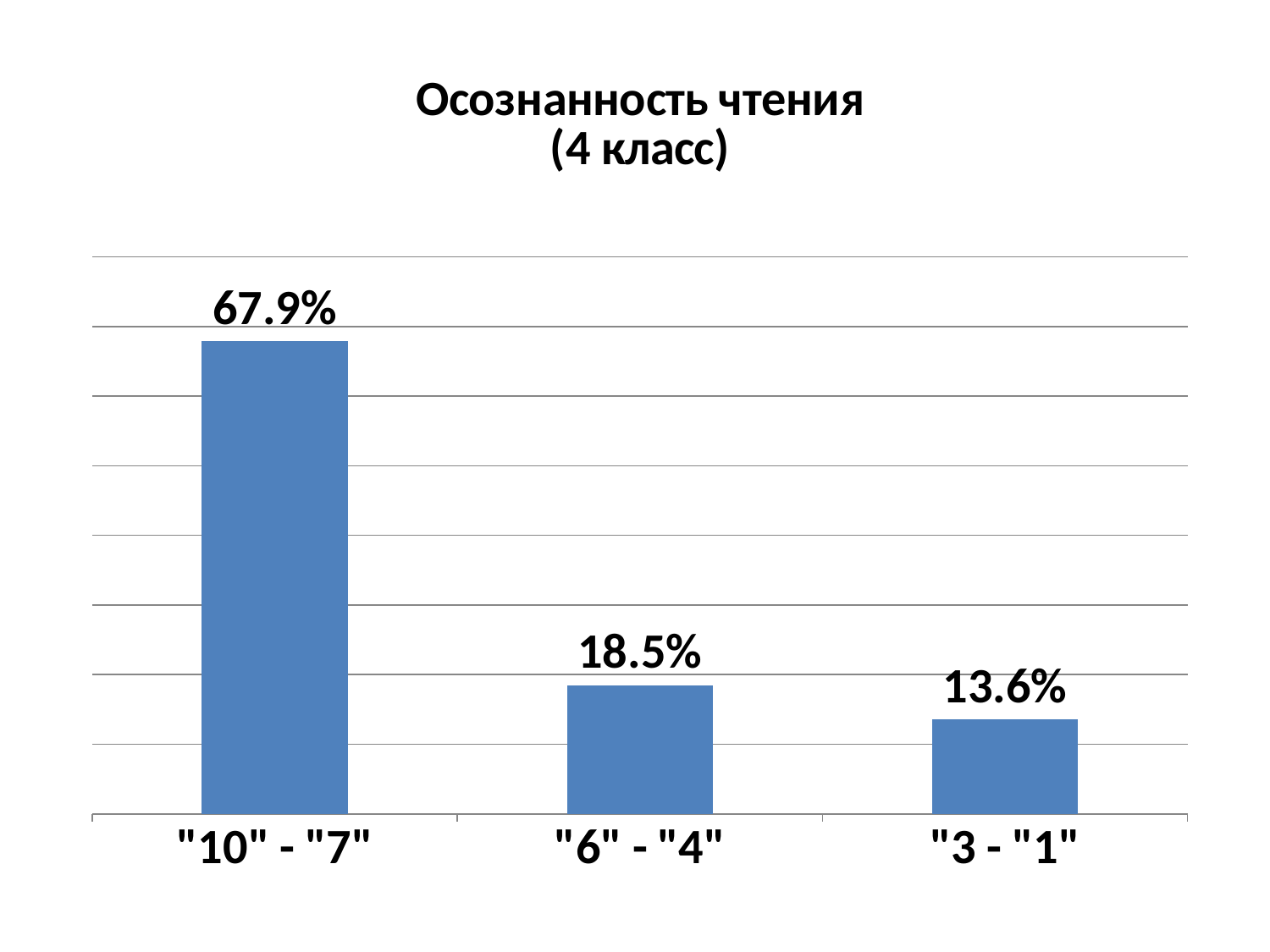
Which category has the highest value? "10" - "7" What is the difference between the values for "6" - "4" and "3 - "1"? 4.9% What is the value for the "10" - "7" category? 67.9% Which category has the lowest value? "3 - "1" What kind of chart is shown on the slide? Bar chart What is the difference between the values for "10" - "7" and "6" - "4"? 49.4% Do the values rise or fall from left to right along the x axis? Fall What is the value for the "3 - "1" category? 13.6% Which is larger, the value for "6" - "4" or the value for "3 - "1"? "6" - "4" What is the value for the "6" - "4" category? 18.5% How many categories are shown on the chart? 3 What is the title of the chart? Осознанность чтения (4 класс)